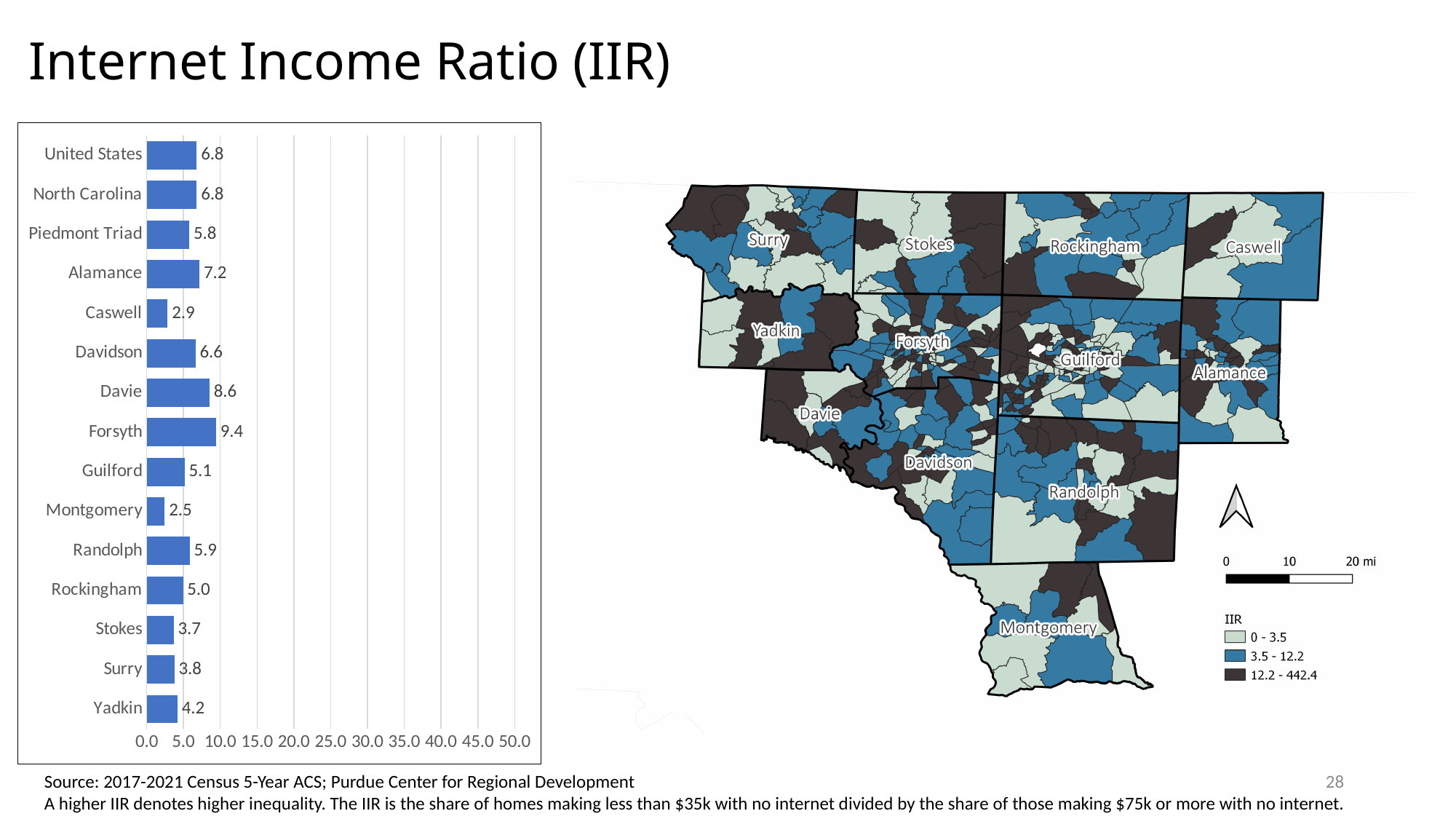
In the bar chart, what is the value for the Piedmont Triad? 5.8 What is the highest value shown on the x axis of the bar chart? 50.0 In the bar chart, which category has the highest value? Forsyth In the bar chart, what is the difference between the values for Stokes and Surry? 0.1 How many categories are shown in the bar chart? 15 In the bar chart, which is larger, the value for Alamance or the value for Davidson? Alamance What kind of chart is on the left side of the slide? bar chart In the bar chart, what is the Internet Income Ratio for Forsyth? 9.4 In the bar chart, what is the value for Caswell? 2.9 In the bar chart, what is the difference between the values for Davie and Guilford? 3.5 In the bar chart, is the value for Randolph greater or less than 10.0? less In the bar chart, which category has the lowest value? Montgomery